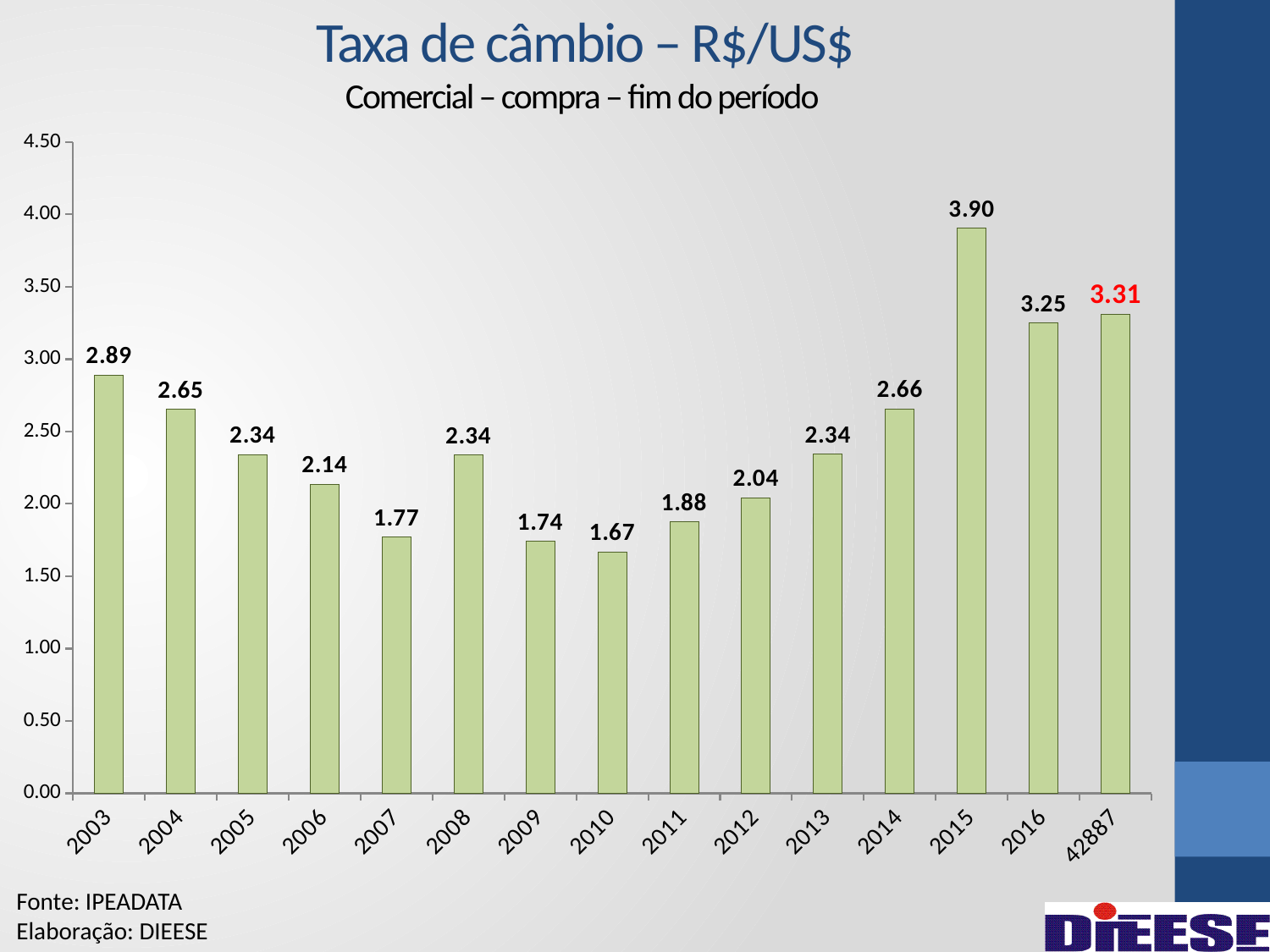
What is the value shown for the last bar, labelled 42887? 3.31 What is the difference between the values for 2015 and 2016? 0.65 Which is larger, the value for 2012 or the value for 2013? 2013 How many bars are plotted on the chart? 15 Is the value for 2014 greater or less than 2.50? greater Do the values rise or fall from 2003 to 2007? fall Which year has the lowest exchange rate value? 2010 Which year has the highest exchange rate value? 2015 What is the value shown for 2010? 1.67 What is the difference between the values for 2003 and 2004? 0.24 What is the exchange rate value shown for 2015? 3.90 What kind of chart is shown on the slide? bar chart